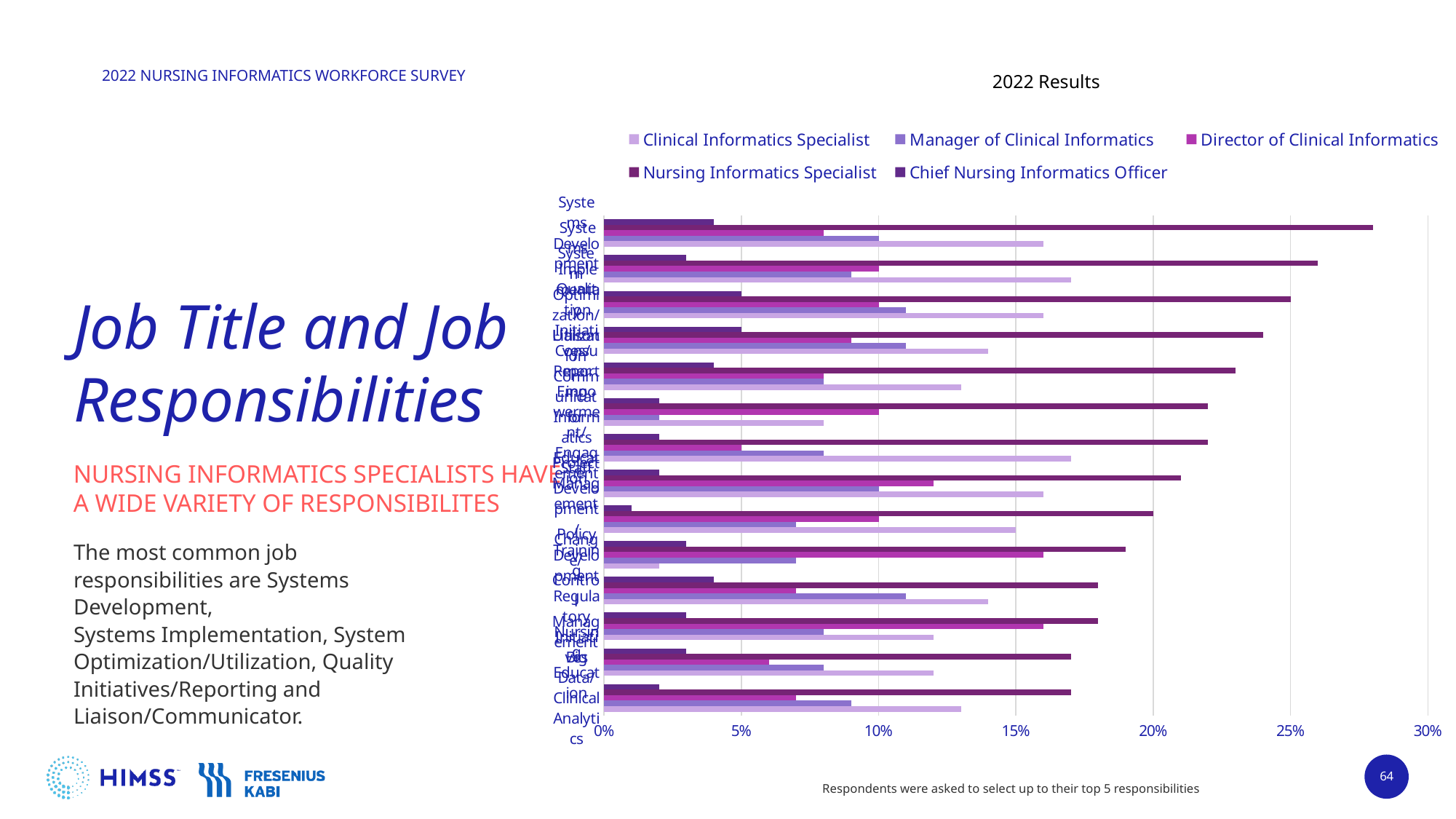
How many series does the chart legend list? 5 In the topmost category group, which is larger: the Nursing Informatics Specialist value or the Clinical Informatics Specialist value? Nursing Informatics Specialist For the topmost category group in the chart, is the Nursing Informatics Specialist value greater or less than 25%? greater What kind of chart is shown on the slide? bar chart Which series is listed first in the chart legend? Clinical Informatics Specialist Which series has the longest bar anywhere in the chart? Nursing Informatics Specialist What is the title of the chart? 2022 Results What is the highest value shown on the chart's horizontal axis? 30% For the topmost category group in the chart, is the Chief Nursing Informatics Officer value greater or less than 5%? less How many category groups of bars are plotted in the chart? 14 In the topmost category group, which is larger: the Manager of Clinical Informatics value or the Chief Nursing Informatics Officer value? Manager of Clinical Informatics For the topmost category group in the chart, is the Clinical Informatics Specialist value greater or less than 10%? greater